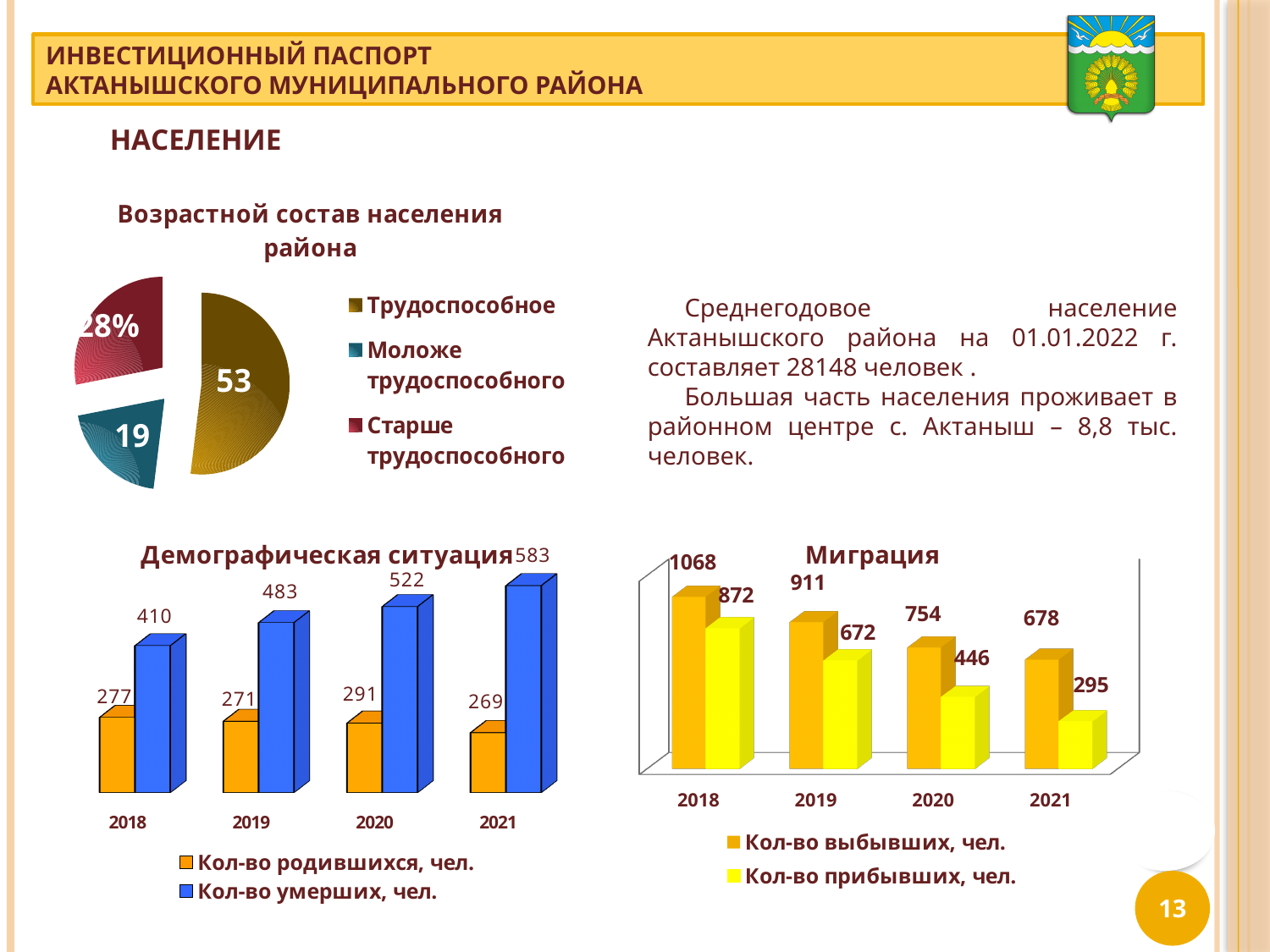
In the 'Возрастной состав населения района' chart, what value is shown for 'Трудоспособное'? 53 In the 'Миграция' chart, which is larger in 2019: 'Кол-во выбывших, чел.' or 'Кол-во прибывших, чел.'? Кол-во выбывших, чел. What type of chart is 'Возрастной состав населения района'? pie chart In the 'Миграция' chart, what is the value of 'Кол-во прибывших, чел.' for 2020? 446 In the 'Демографическая ситуация' chart, what is the value of 'Кол-во умерших, чел.' for 2021? 583 In the 'Миграция' chart, what is the difference between 'Кол-во выбывших, чел.' and 'Кол-во прибывших, чел.' in 2021? 383 In the 'Миграция' chart, what is the value of 'Кол-во выбывших, чел.' for 2018? 1068 In the 'Демографическая ситуация' chart, which year has the highest value for 'Кол-во умерших, чел.'? 2021 In the 'Демографическая ситуация' chart, does the value of 'Кол-во умерших, чел.' rise or fall from 2018 to 2021? rise In the 'Демографическая ситуация' chart, what is the difference between 'Кол-во умерших, чел.' and 'Кол-во родившихся, чел.' in 2019? 212 In the 'Миграция' chart, which year has the lowest value for 'Кол-во прибывших, чел.'? 2021 In the 'Демографическая ситуация' chart, what is the value of 'Кол-во родившихся, чел.' for 2020? 291